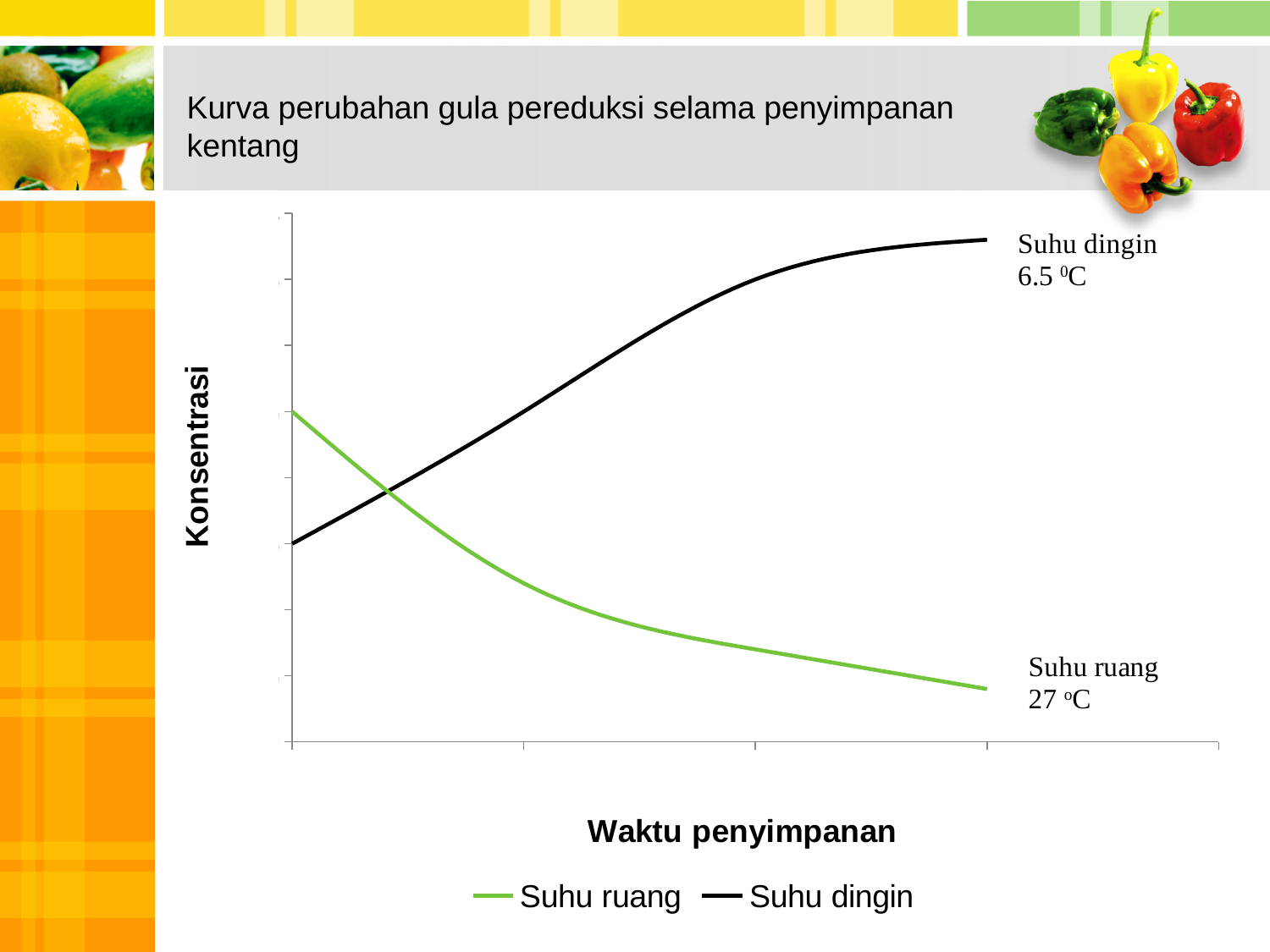
At the left end of the chart, which series starts higher, Suhu ruang or Suhu dingin? Suhu ruang What kind of chart is shown on the slide? line chart What temperature is annotated next to the Suhu dingin line? 6.5 °C What is the title of the y axis? Konsentrasi At the right end of the chart, which series is higher, Suhu ruang or Suhu dingin? Suhu dingin What temperature is annotated next to the Suhu ruang line? 27 °C Which series is drawn in green? Suhu ruang Does the Suhu dingin line rise or fall along the x axis? rise How many series does the legend list? 2 What is the title of the x axis? Waktu penyimpanan Does the Suhu ruang line rise or fall along the x axis? fall